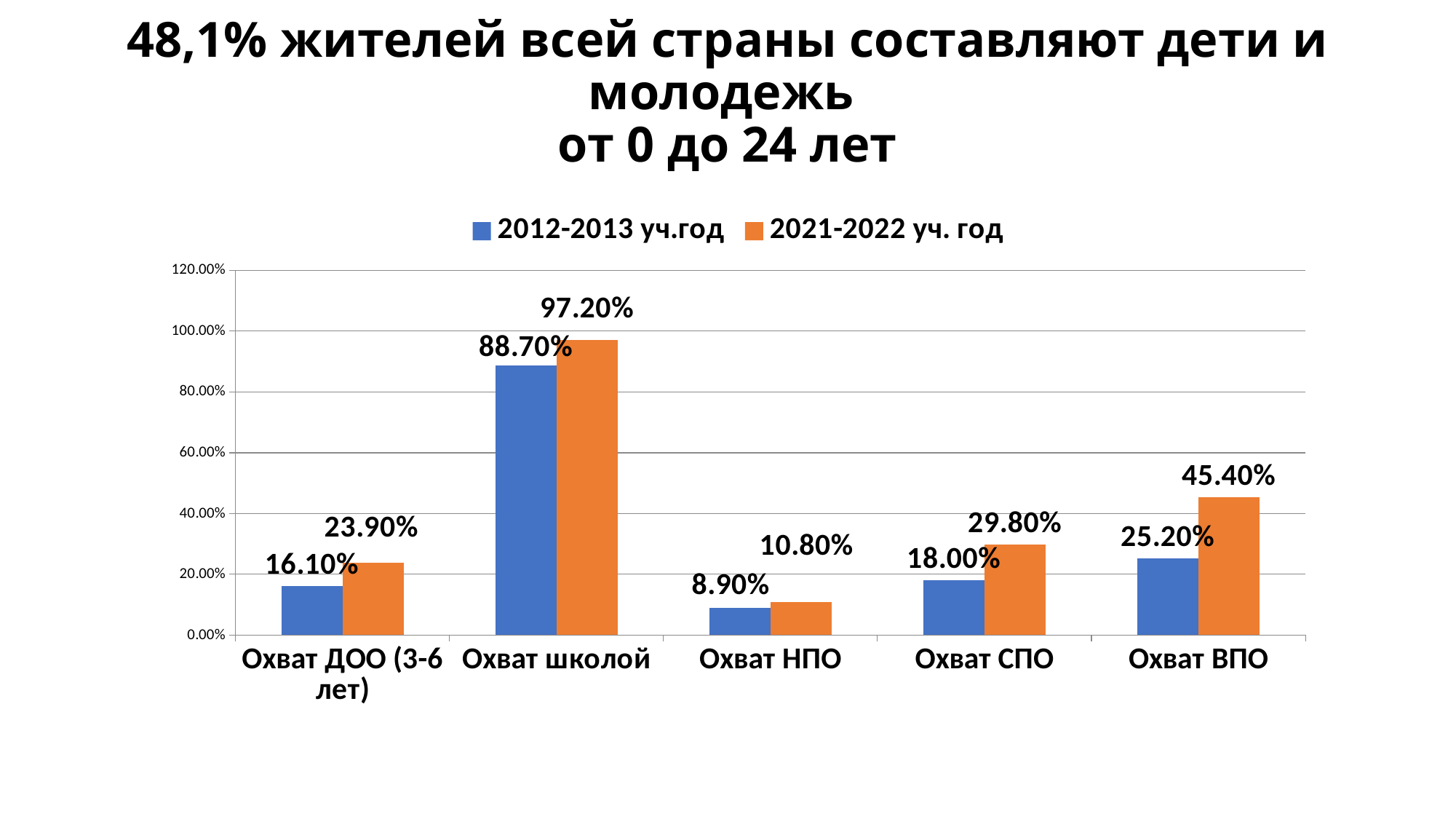
What kind of chart is shown on the slide? Bar chart Which category has the lowest value in the 2021-2022 уч. год series? Охват НПО How many categories are shown on the x axis? 5 Which category has the highest value in the 2012-2013 уч.год series? Охват школой What is the value for Охват ВПО in the 2021-2022 уч. год series? 45.40% What is the difference between the 2021-2022 уч. год and 2012-2013 уч.год values for Охват ВПО? 20.20% Which is larger: the 2012-2013 уч.год value for Охват ВПО or the 2021-2022 уч. год value for Охват ДОО (3-6 лет)? 2012-2013 уч.год value for Охват ВПО Which colour represents the 2021-2022 уч. год series? Orange What is the difference between the 2021-2022 уч. год and 2012-2013 уч.год values for Охват СПО? 11.80% What is the value for Охват школой in the 2021-2022 уч. год series? 97.20% What is the value for Охват ДОО (3-6 лет) in the 2012-2013 уч.год series? 16.10% How many series does the legend list? 2